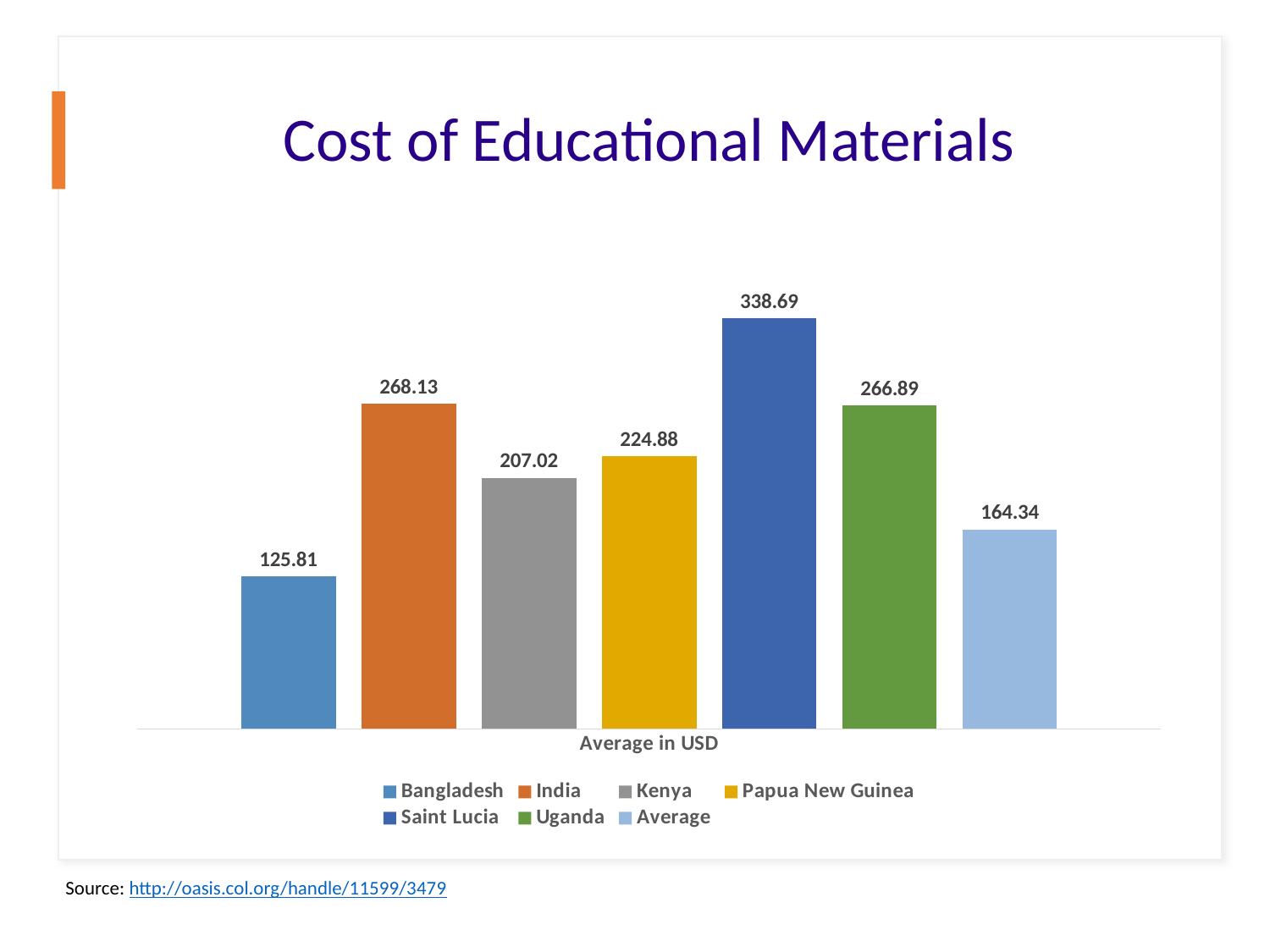
What is the value shown for Average? 164.34 What type of chart is shown on the slide? Bar chart Which bar has the lowest value? Bangladesh How many bars are plotted in the chart? 7 What is the value for Papua New Guinea? 224.88 What is the difference between the values for India and Kenya? 61.11 Which is larger, the value for Kenya or the value for Papua New Guinea? Papua New Guinea How many entries does the legend list? 7 Which country has the highest cost of educational materials? Saint Lucia What is the difference between the values for Saint Lucia and Bangladesh? 212.88 What is the value for Bangladesh? 125.81 What is the value for Saint Lucia? 338.69